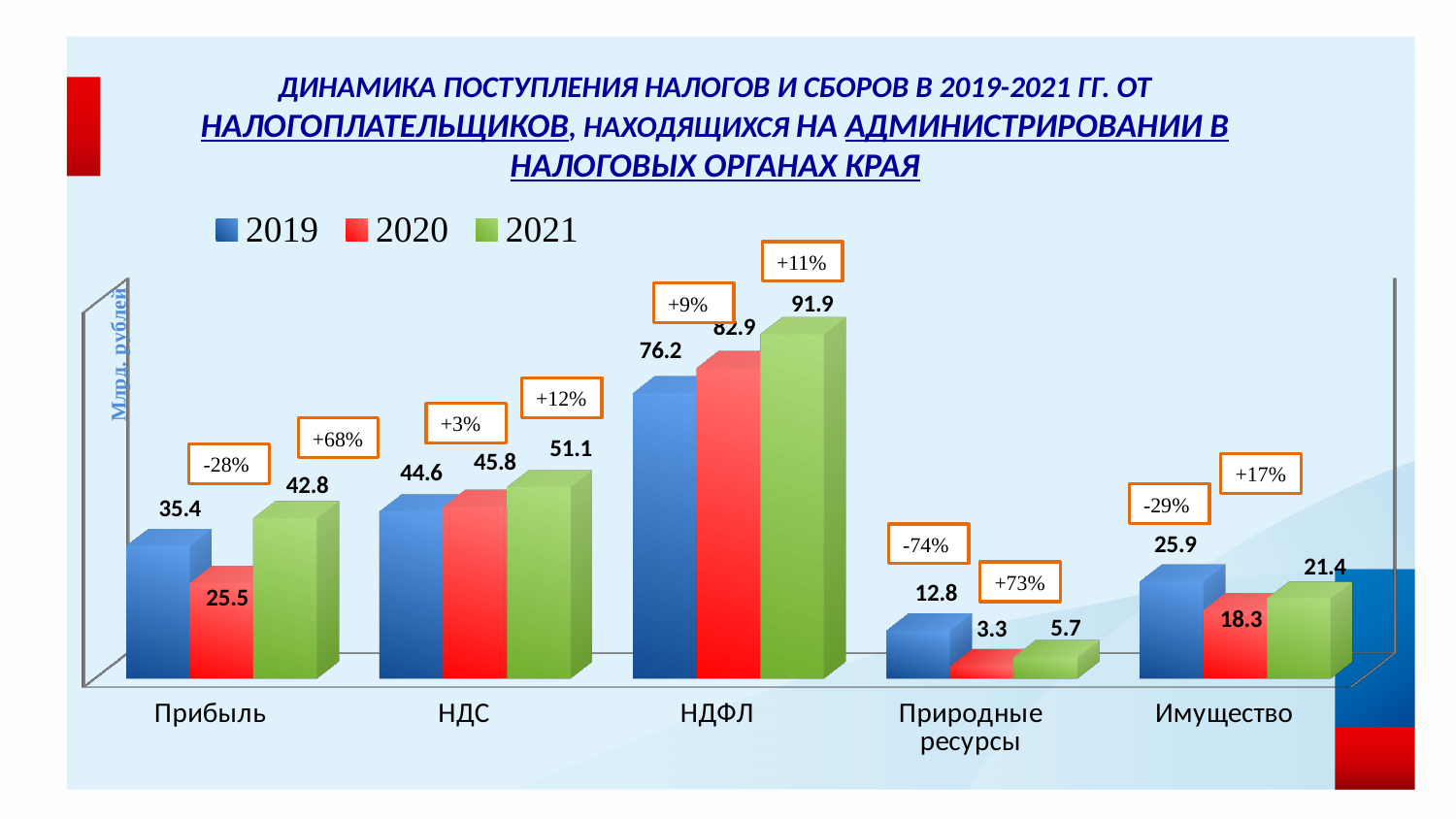
What is the difference between the 2021 and 2019 values for Прибыль? 7.4 Which colour represents the 2020 series in the legend? Red What is the value for Имущество in 2021? 21.4 Which category has the highest value in 2021? НДФЛ What is the value for НДФЛ in 2021? 91.9 What is the value for Природные ресурсы in 2019? 12.8 How many series does the legend list? 3 What is the value for Прибыль in 2020? 25.5 Which category has the lowest value in 2020? Природные ресурсы How many categories are shown on the x axis? 5 What kind of chart is shown on the slide? Bar chart Which is larger for НДС: the 2020 value or the 2021 value? 2021